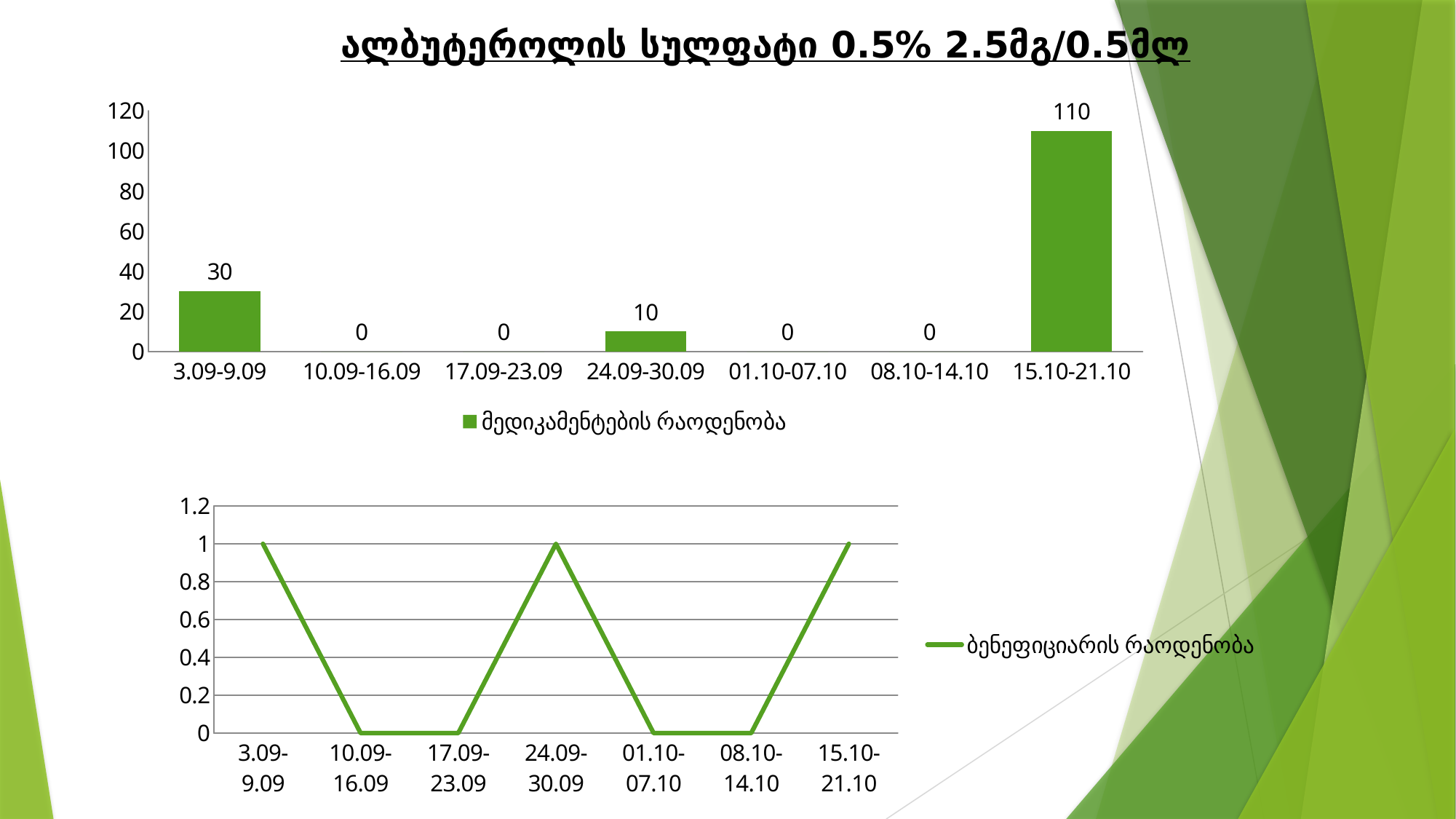
In the top bar chart, which is larger: the value for 3.09-9.09 or the value for 24.09-30.09? 3.09-9.09 In the top bar chart, which category has the highest value? 15.10-21.10 In the top bar chart, what is the value for 15.10-21.10? 110 In the top bar chart, what is the value for 3.09-9.09? 30 In the top bar chart, what is the value for 24.09-30.09? 10 In the top bar chart, what is the difference between the values for 15.10-21.10 and 3.09-9.09? 80 In the bottom line chart, what is the value for 01.10-07.10? 0 In the bottom line chart, what is the value for 24.09-30.09? 1 What kind of chart is the top chart? bar chart In the top bar chart, how many categories have a value of 0? 4 In the top bar chart, how many categories are shown on the x axis? 7 What kind of chart is the bottom chart? line chart